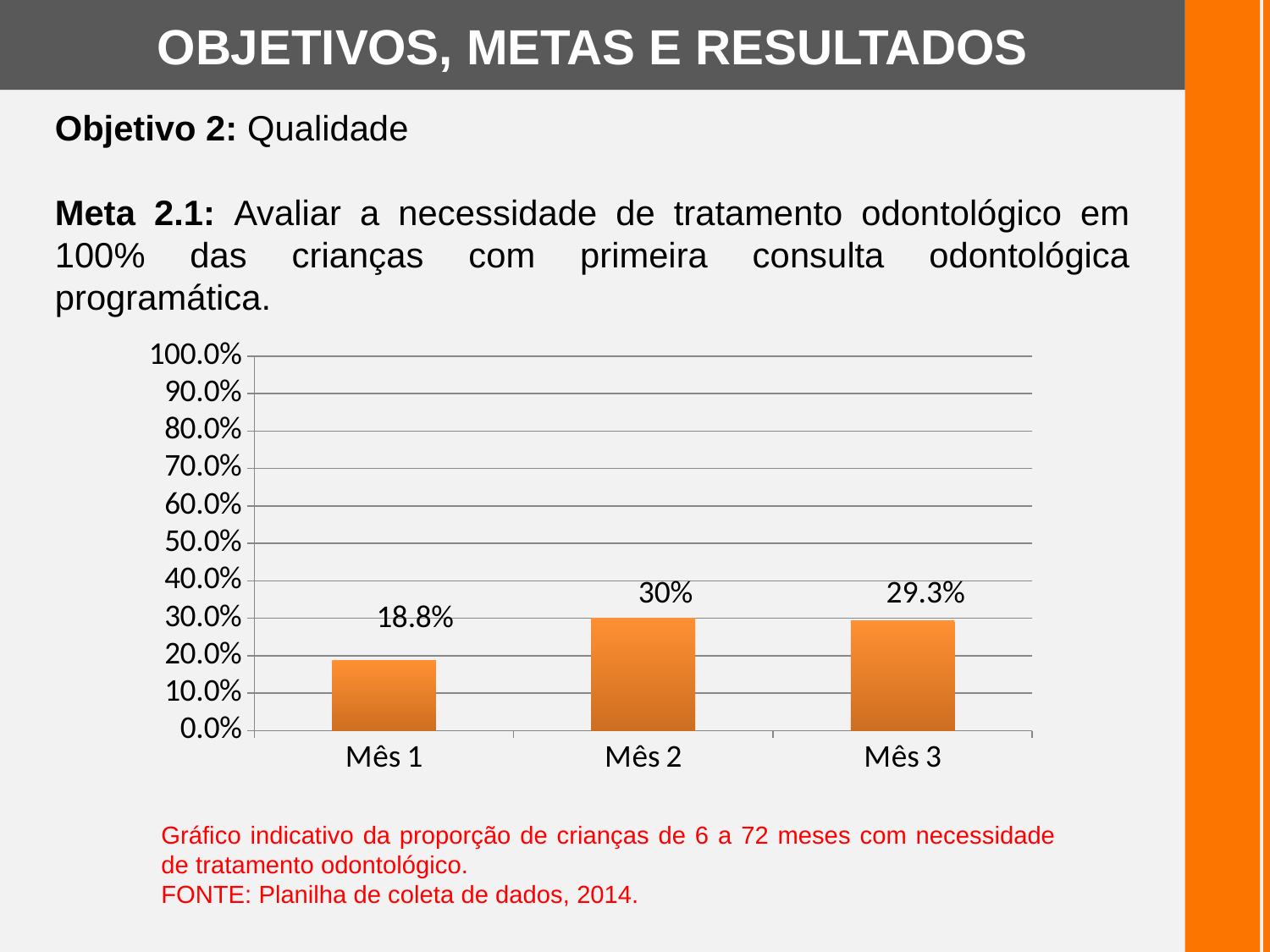
Is the value for Mês 1 greater or less than 20.0%? less Which month has the highest value? Mês 2 What is the value for Mês 2? 30% Which is larger, the value for Mês 1 or the value for Mês 3? Mês 3 What is the value for Mês 3? 29.3% What is the maximum value shown on the y axis? 100.0% What is the difference between the values for Mês 2 and Mês 1? 11.2% What colour are the bars in the chart? orange What is the value for Mês 1? 18.8% How many categories are shown on the x axis? 3 What kind of chart is shown on the slide? bar chart Which month has the lowest value? Mês 1